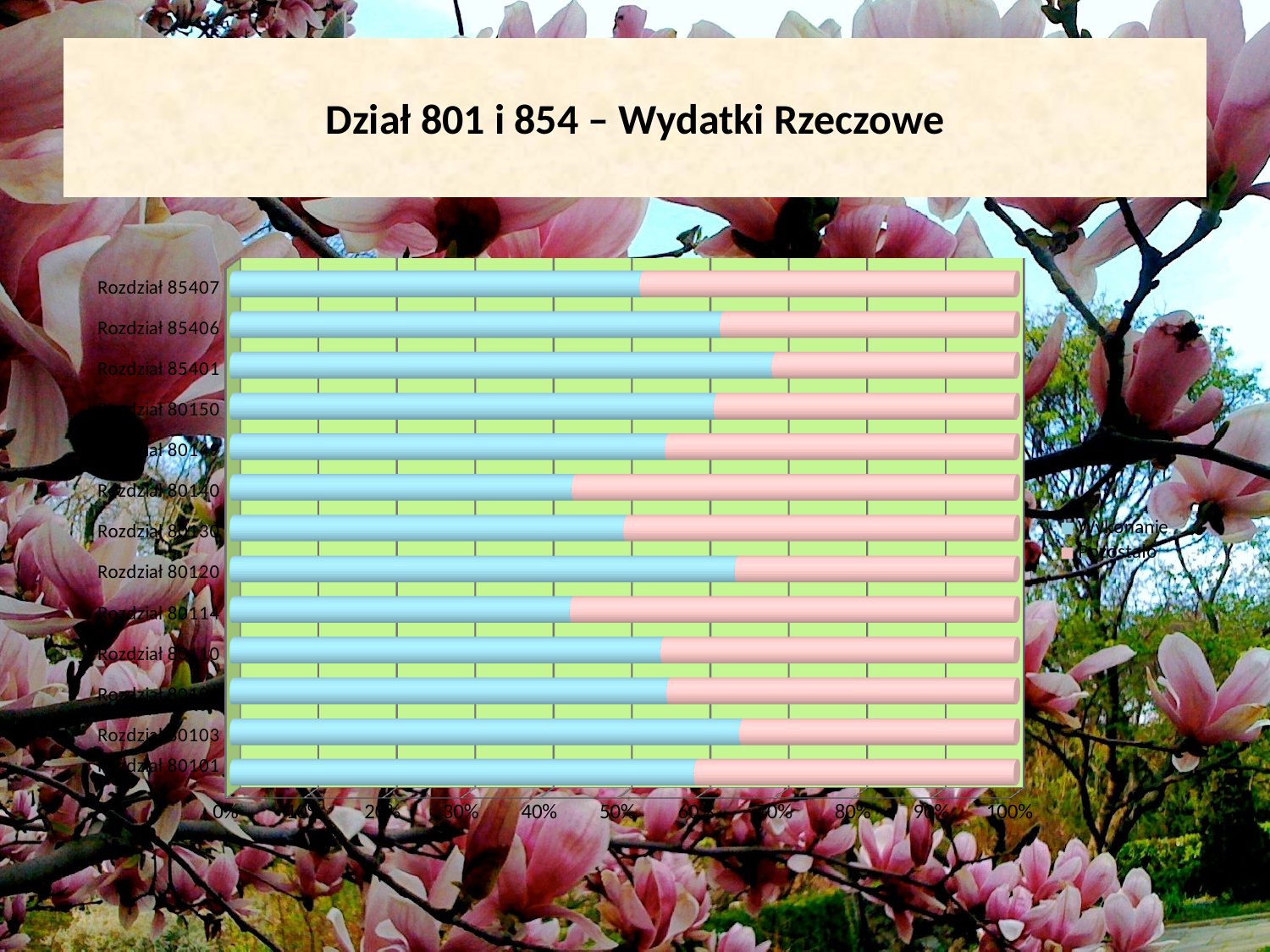
Which has the larger Wykonanie share, Rozdział 85407 or Rozdział 80114? Rozdział 85407 What kind of chart is shown on the slide? bar chart What is the title of the slide containing the chart? Dział 801 i 854 – Wydatki Rzeczowe Which has the larger Wykonanie share, Rozdział 85406 or Rozdział 80140? Rozdział 85406 What are the two series named in the legend? Wykonanie and Pozostało Is the Wykonanie value for Rozdział 80120 greater or less than 60%? greater Is the Wykonanie value for Rozdział 80140 greater or less than 50%? less How many series does the legend list? 2 How many bars (categories) are plotted in the chart? 13 Is the Wykonanie value for Rozdział 80114 greater or less than 50%? less